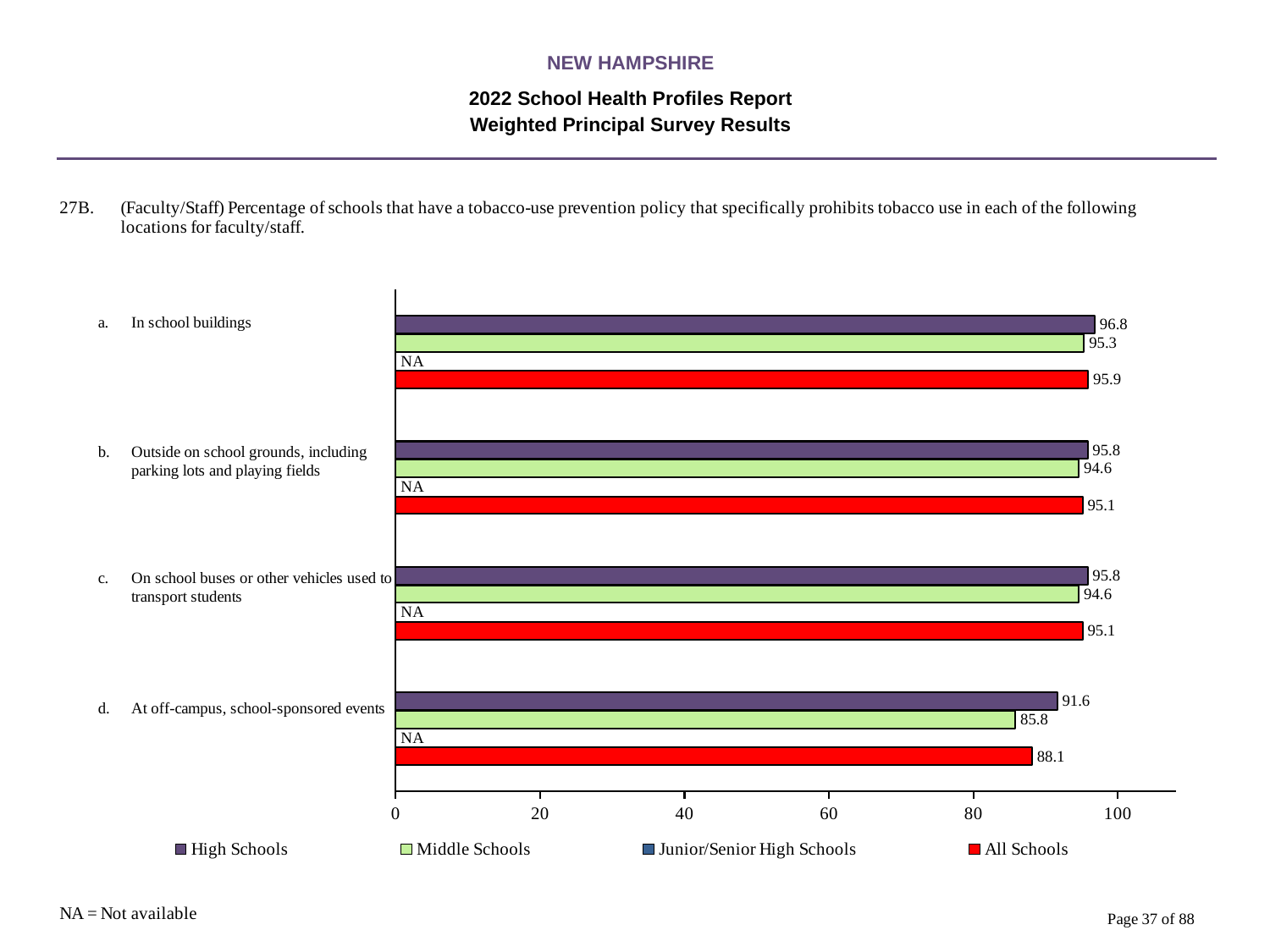
Is the All Schools value for 'At off-campus, school-sponsored events' greater or less than 80? greater What value is shown for Junior/Senior High Schools in each category? NA What is the value for High Schools for 'In school buildings'? 96.8 How many series does the legend list? 4 What kind of chart is shown on the slide? bar chart How many locations (categories) are shown on the chart? 4 What is the value for Middle Schools for 'Outside on school grounds, including parking lots and playing fields'? 94.6 Which location has the lowest value for Middle Schools? At off-campus, school-sponsored events What is the value for All Schools for 'At off-campus, school-sponsored events'? 88.1 Which is larger for 'On school buses or other vehicles used to transport students': the High Schools value or the All Schools value? High Schools Which location has the highest value for High Schools? In school buildings What is the difference between the High Schools and Middle Schools values for 'At off-campus, school-sponsored events'? 5.8